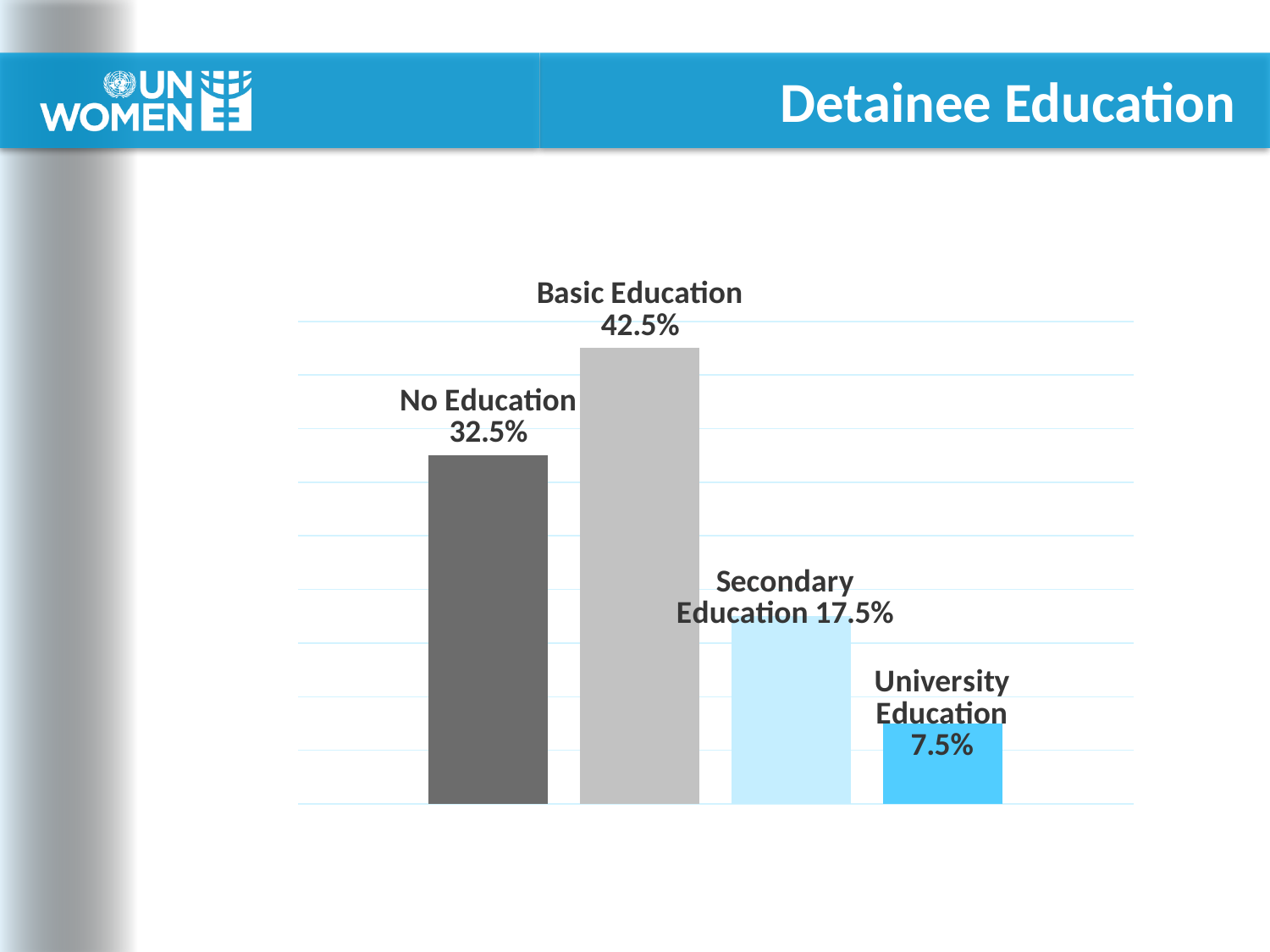
Which is larger, the percentage for No Education or for Secondary Education? No Education What percentage of detainees have secondary education? 17.5% Which education category has the highest percentage? Basic Education How many education categories are shown in the chart? 4 Which education category has the lowest percentage? University Education What percentage of detainees have university education? 7.5% What is the difference between the Basic Education and No Education percentages? 10% What is the difference between the Secondary Education and University Education percentages? 10% What type of chart is shown on the slide? Bar chart What percentage of detainees have no education? 32.5% What is the title of the slide containing the chart? Detainee Education What percentage of detainees have basic education? 42.5%